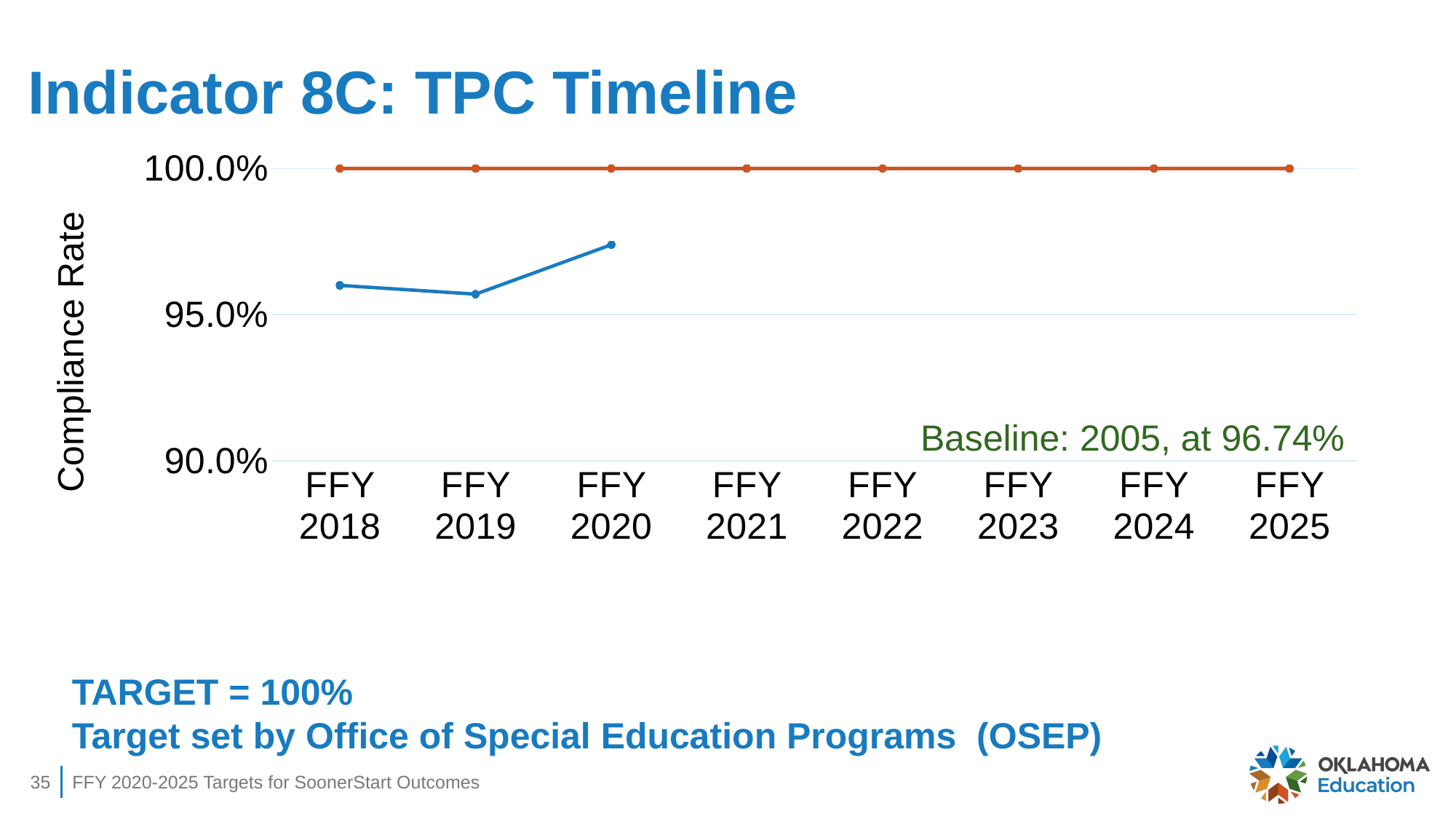
Which FFY has the highest value on the blue line? FFY 2020 Which FFY has the lowest value on the blue line? FFY 2019 On the blue line, which is larger: the value for FFY 2019 or FFY 2020? FFY 2020 What kind of chart is shown on the slide? line chart Is the blue line's value for FFY 2018 greater or less than 100.0%? less What is the label on the y axis of the chart? Compliance Rate Is the blue line's value for FFY 2020 greater or less than 95.0%? greater Does the blue line rise or fall from FFY 2019 to FFY 2020? rise What is the value of the orange target line at FFY 2021? 100.0% How many data points does the blue line have? 3 How many FFY categories are shown on the x axis? 8 What is the value of the orange target line at FFY 2025? 100.0%